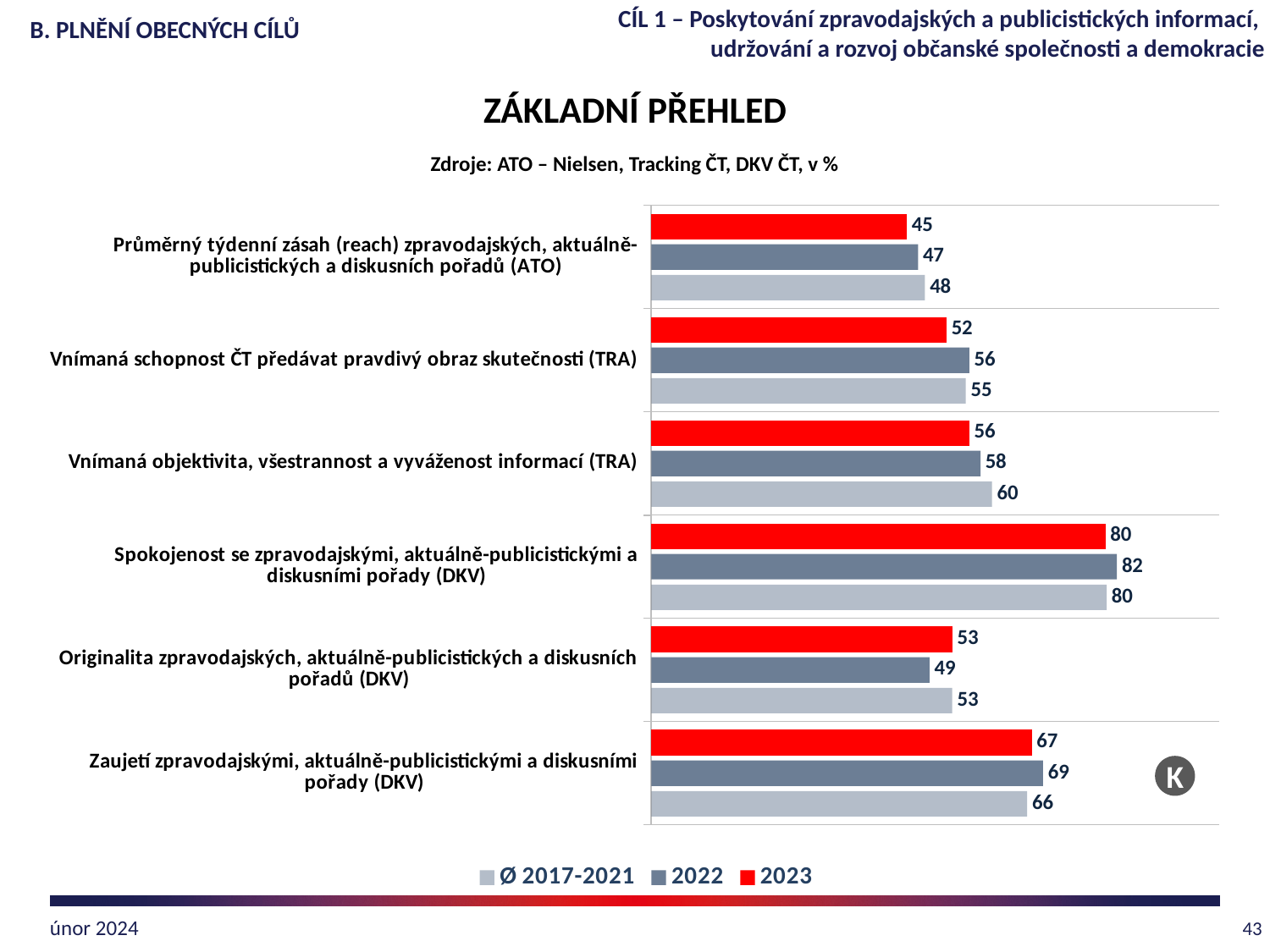
What is the 2022 value for 'Vnímaná schopnost ČT předávat pravdivý obraz skutečnosti (TRA)'? 56 Which category has the highest 2023 value? Spokojenost se zpravodajskými, aktuálně-publicistickými a diskusními pořady (DKV) What is the difference between the 2022 and 2023 values for 'Originalita zpravodajských, aktuálně-publicistických a diskusních pořadů (DKV)'? 4 How many series does the legend list? 3 How many categories are shown in the chart? 6 What is the Ø 2017-2021 value for 'Vnímaná objektivita, všestrannost a vyváženost informací (TRA)'? 60 Which category has the lowest 2022 value? Průměrný týdenní zásah (reach) zpravodajských, aktuálně-publicistických a diskusních pořadů (ATO) What kind of chart is shown on the slide? Bar chart What is the 2023 value for 'Průměrný týdenní zásah (reach) zpravodajských, aktuálně-publicistických a diskusních pořadů (ATO)'? 45 What is the 2023 value for 'Spokojenost se zpravodajskými, aktuálně-publicistickými a diskusními pořady (DKV)'? 80 For 'Zaujetí zpravodajskými, aktuálně-publicistickými a diskusními pořady (DKV)', which is larger: the 2022 value or the Ø 2017-2021 value? 2022 Which series is shown in red in the chart? 2023